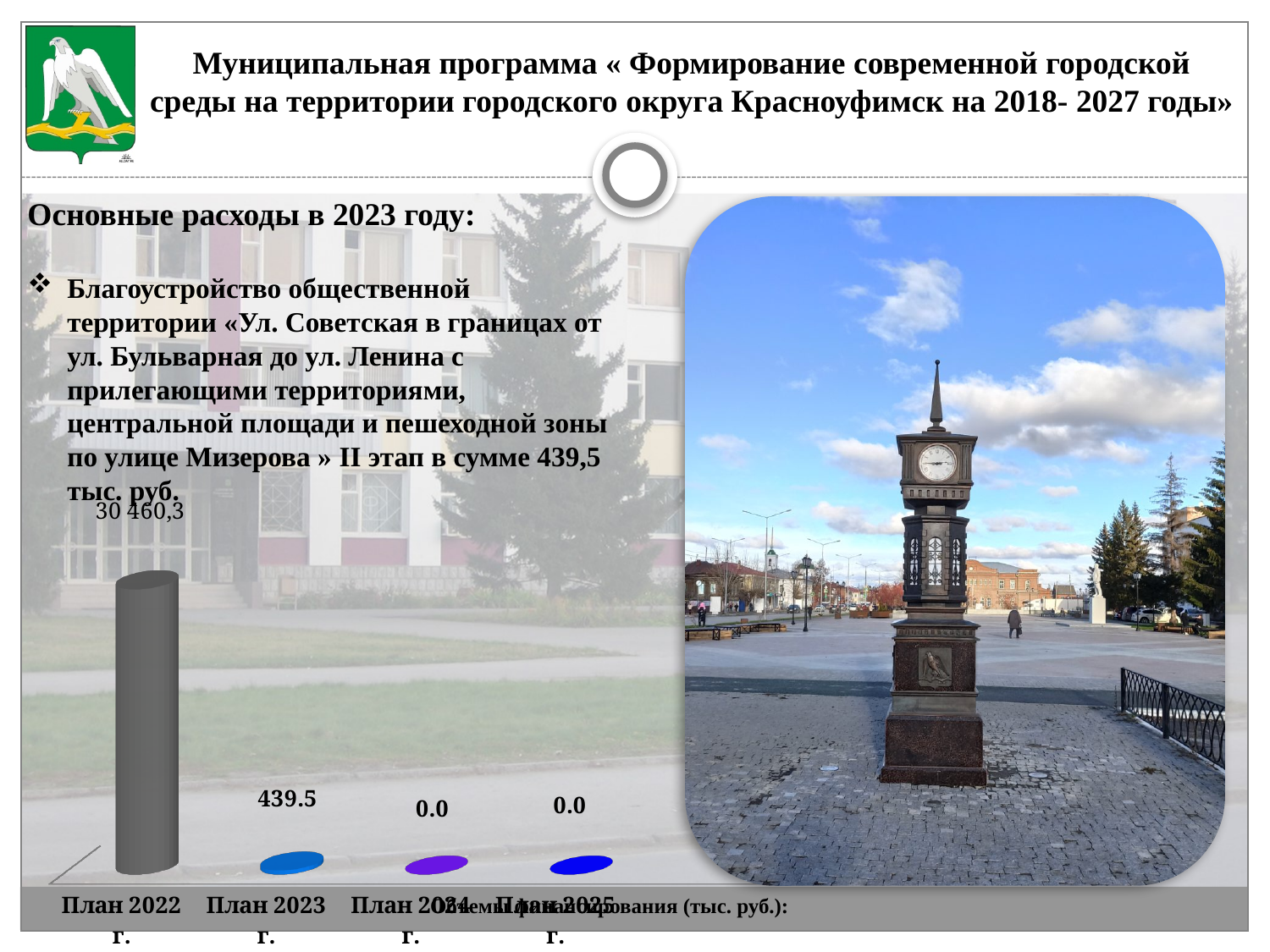
Which category has the highest value? План 2022 г. How many categories are plotted in the chart? 4 What is the difference between the values for План 2023 г. and План 2024 г.? 439.5 Do the values rise or fall from План 2022 г. to План 2025 г.? fall Which is larger, the value for План 2022 г. or План 2023 г.? План 2022 г. What type of chart is shown on the slide? bar chart Which is larger, the value for План 2023 г. or План 2024 г.? План 2023 г. What is the value for План 2022 г.? 30 460,3 What is the value for План 2023 г.? 439.5 What unit is stated for the financing volumes in the chart caption? тыс. руб. What is the value for План 2025 г.? 0.0 What is the value for План 2024 г.? 0.0